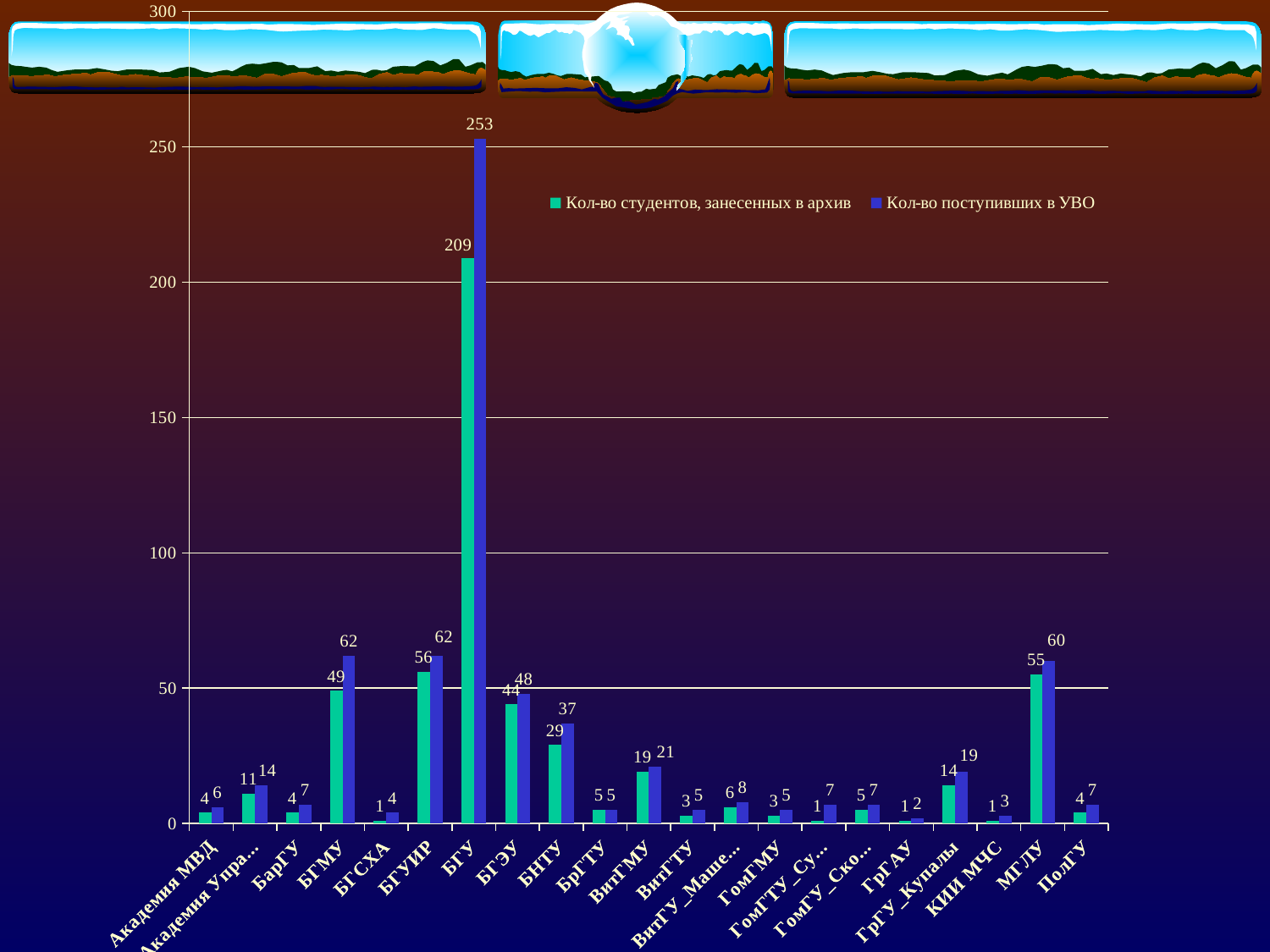
Which category has the highest value for "Кол-во поступивших в УВО"? БГУ Which is larger: "Кол-во студентов, занесенных в архив" for БГУИР or for МГЛУ? БГУИР What is the value of "Кол-во поступивших в УВО" for БГУ? 253 What is the difference between "Кол-во поступивших в УВО" and "Кол-во студентов, занесенных в архив" for БГУ? 44 What is the difference between "Кол-во поступивших в УВО" and "Кол-во студентов, занесенных в архив" for БГМУ? 13 What is the value of "Кол-во студентов, занесенных в архив" for БГУ? 209 Is the value of "Кол-во поступивших в УВО" for БГУ greater or less than 250? greater How many series does the legend list? 2 What is the value of "Кол-во студентов, занесенных в архив" for БНТУ? 29 What kind of chart is shown on the slide? Bar chart How many categories are shown on the x axis? 21 What is the value of "Кол-во поступивших в УВО" for МГЛУ? 60